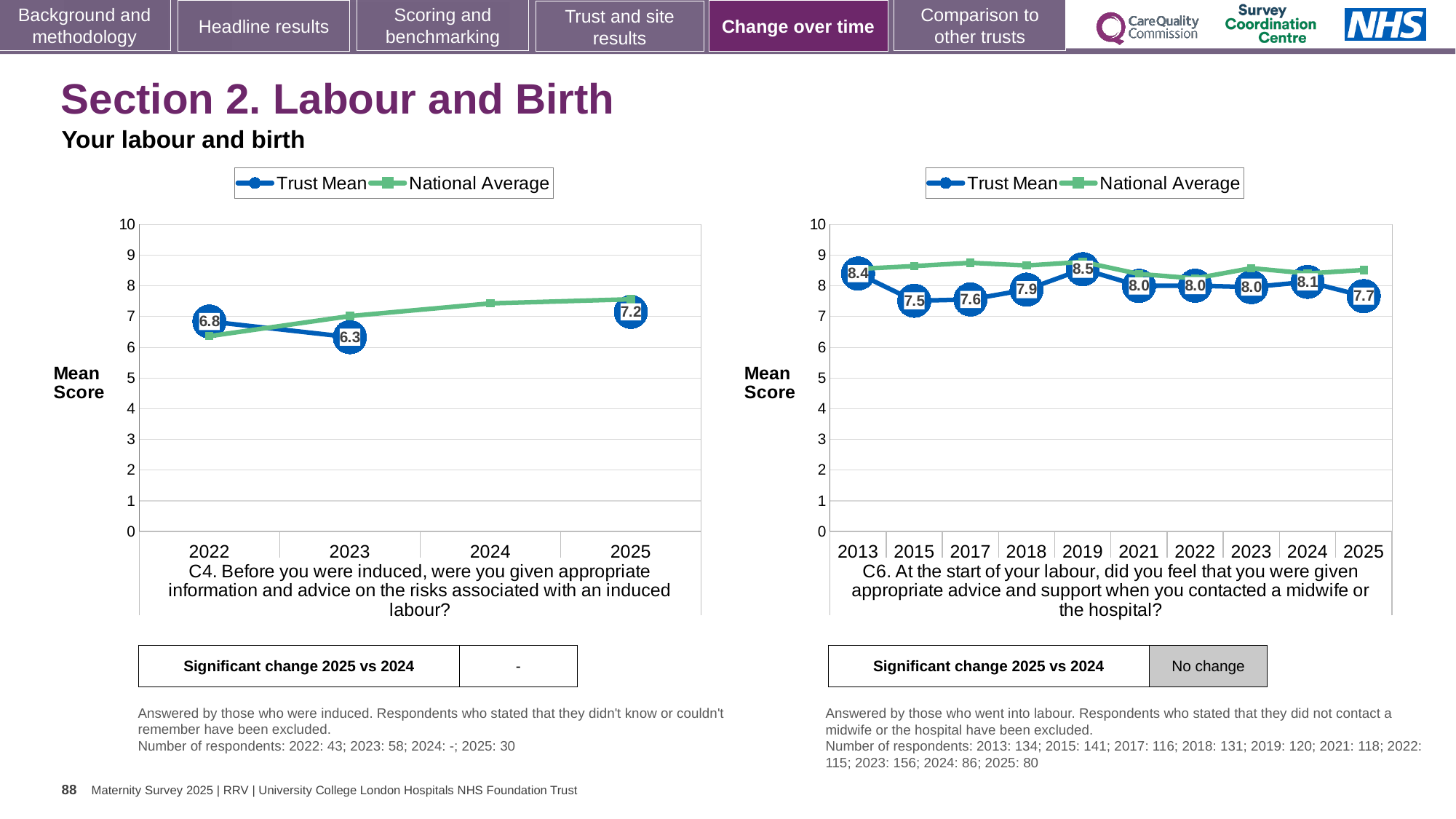
In the C4 chart on the left, what is the Trust Mean score for 2025? 7.2 In the C6 chart on the right, which year has the highest Trust Mean score? 2019 What type of chart is used for the C6 question on the right? Line chart In the C4 chart on the left, what is the Trust Mean score for 2022? 6.8 In the C6 chart on the right, is the Trust Mean score higher in 2013 or in 2025? 2013 In the C6 chart on the right, what is the difference between the Trust Mean scores for 2024 and 2025? 0.4 How many years are shown on the x axis of the C6 chart on the right? 10 How many series does the legend of the C4 chart on the left list? 2 In the C4 chart on the left, which year has the lowest Trust Mean score? 2023 In the C6 chart on the right, which year has the lowest Trust Mean score? 2015 In the C6 chart on the right, what is the Trust Mean score for 2019? 8.5 In the C4 chart on the left, what is the difference between the Trust Mean scores for 2025 and 2023? 0.9